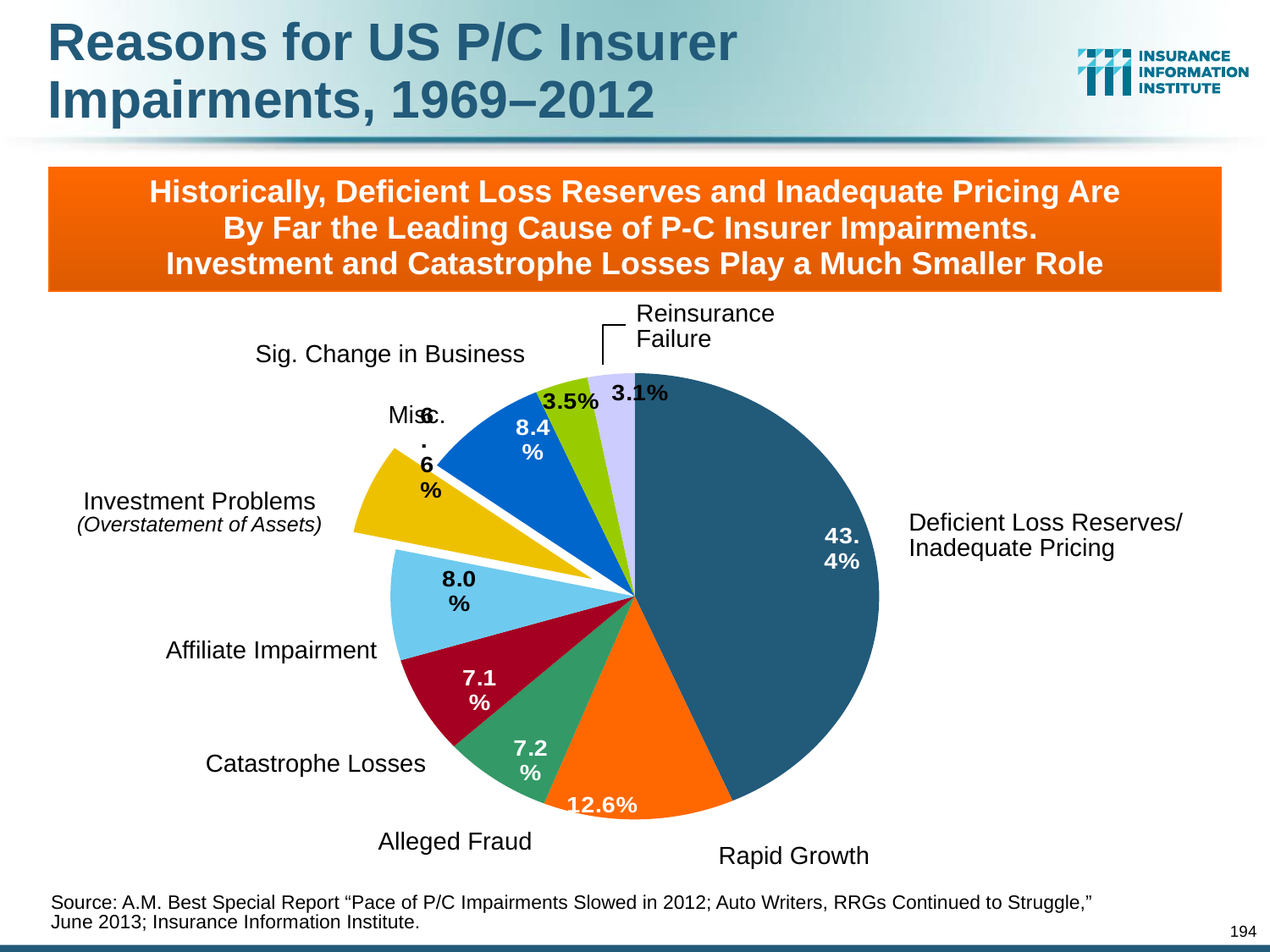
What percentage of impairments is attributed to Reinsurance Failure? 3.1% Which reason accounts for the largest share of impairments? Deficient Loss Reserves/Inadequate Pricing How many reasons (slices) are shown in the pie chart? 9 Which is larger, the share for Affiliate Impairment or the share for Catastrophe Losses? Affiliate Impairment What kind of chart is shown on the slide? Pie chart What percentage of impairments is attributed to Affiliate Impairment? 8.0% How many percentage points larger is the Deficient Loss Reserves/Inadequate Pricing share than the Rapid Growth share? 30.8 percentage points Which reason accounts for the smallest share of impairments? Reinsurance Failure What percentage of impairments is attributed to Rapid Growth? 12.6% What percentage of impairments is attributed to Catastrophe Losses? 7.1% What percentage of impairments is attributed to Alleged Fraud? 7.2% What share of US P/C insurer impairments is attributed to Deficient Loss Reserves/Inadequate Pricing? 43.4%